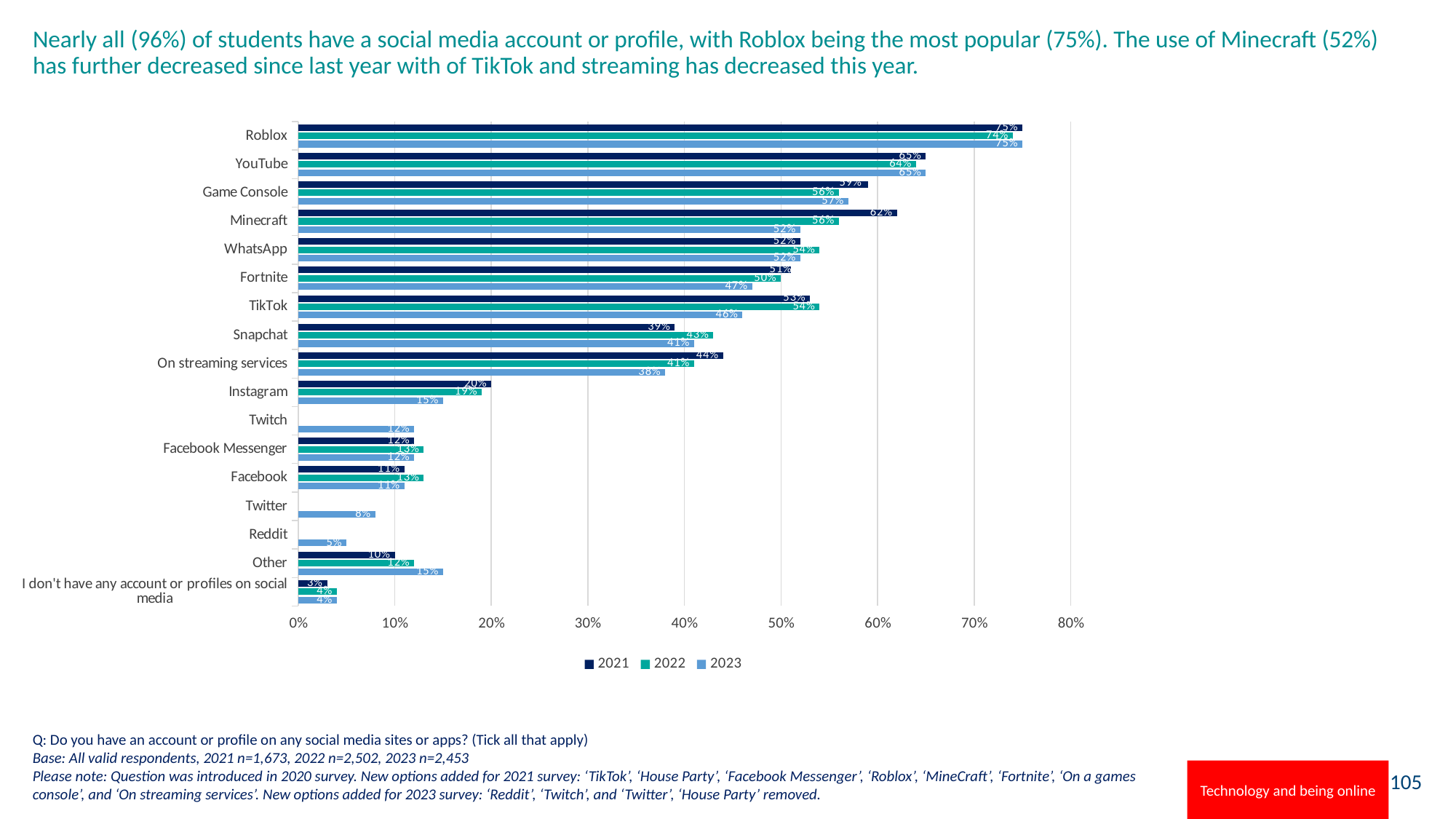
What is the difference between the 2021 and 2023 values for Minecraft? 10 percentage points What is the 2023 value for Reddit? 5% How many series does the legend list? 3 What are the entries listed in the legend? 2021, 2022, 2023 What is the 2023 value for TikTok? 46% Do the values for Minecraft rise or fall from 2021 to 2023? fall What kind of chart is shown on the slide? bar chart What is the 2023 value for Twitter? 8% What is the 2023 value for Minecraft? 52% Which has the larger 2023 value, Snapchat or On streaming services? Snapchat Which category has the highest 2023 value? Roblox How many categories are shown on the y axis of the chart? 17